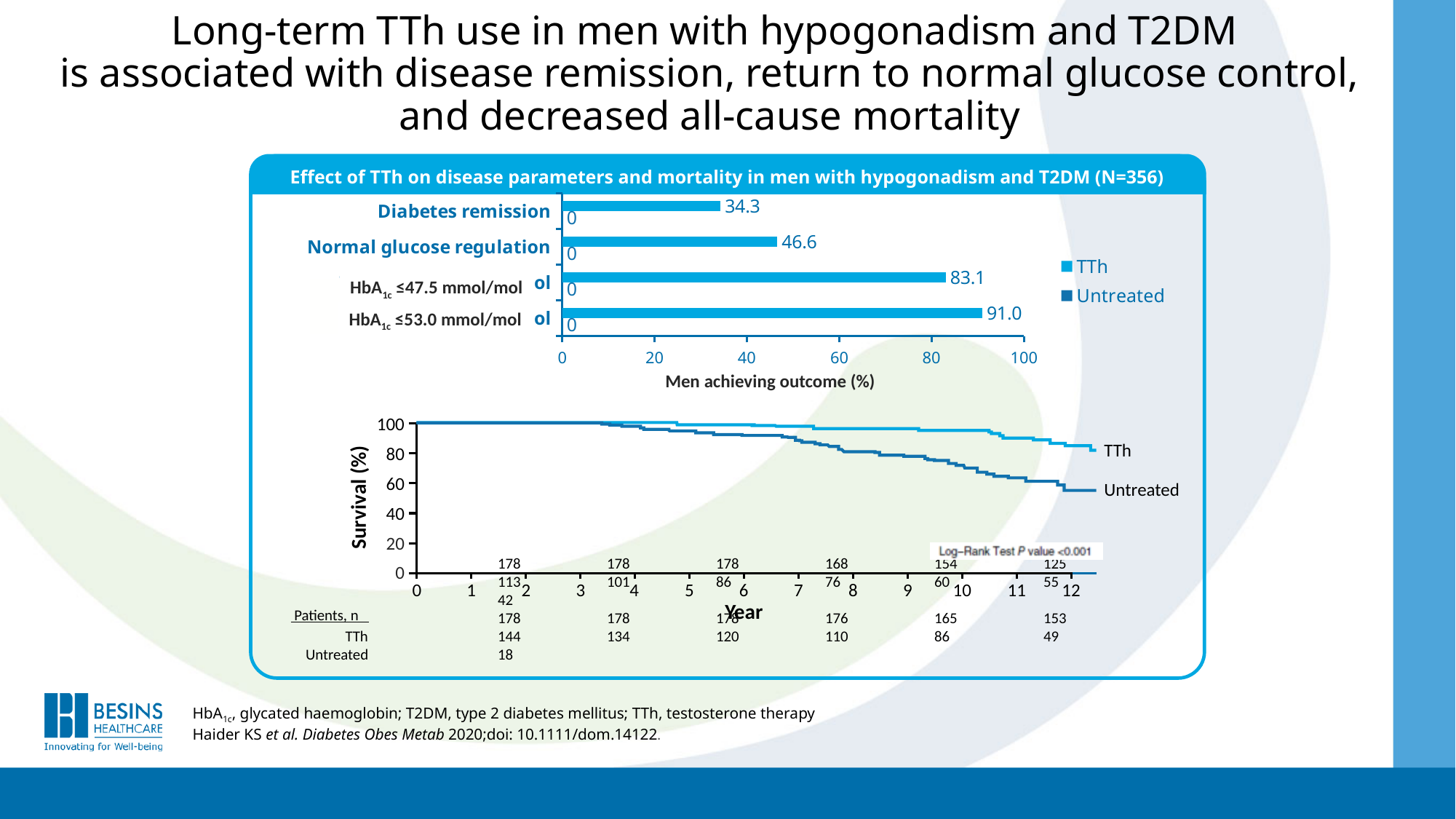
In the top bar chart, what is the TTh value for HbA1c ≤53.0 mmol/mol? 91.0 In the bottom survival chart, is the Untreated survival at year 12 greater or less than 60? less In the top bar chart, which outcome has the highest TTh value? HbA1c ≤53.0 mmol/mol In the top bar chart, what is the Untreated value for HbA1c ≤47.5 mmol/mol? 0 In the top bar chart, what is the TTh value for normal glucose regulation? 46.6 What type of chart is the top chart on the slide? Bar chart In the top bar chart, which is larger for the TTh group: diabetes remission or normal glucose regulation? Normal glucose regulation How many series does the legend of the top bar chart list? 2 In the top bar chart, what percentage of TTh-treated men achieved diabetes remission? 34.3 In the top bar chart, what is the difference between the TTh values for HbA1c ≤53.0 mmol/mol and HbA1c ≤47.5 mmol/mol? 7.9 What is the x-axis label of the bottom survival chart? Year In the top bar chart, which outcome has the lowest TTh value? Diabetes remission